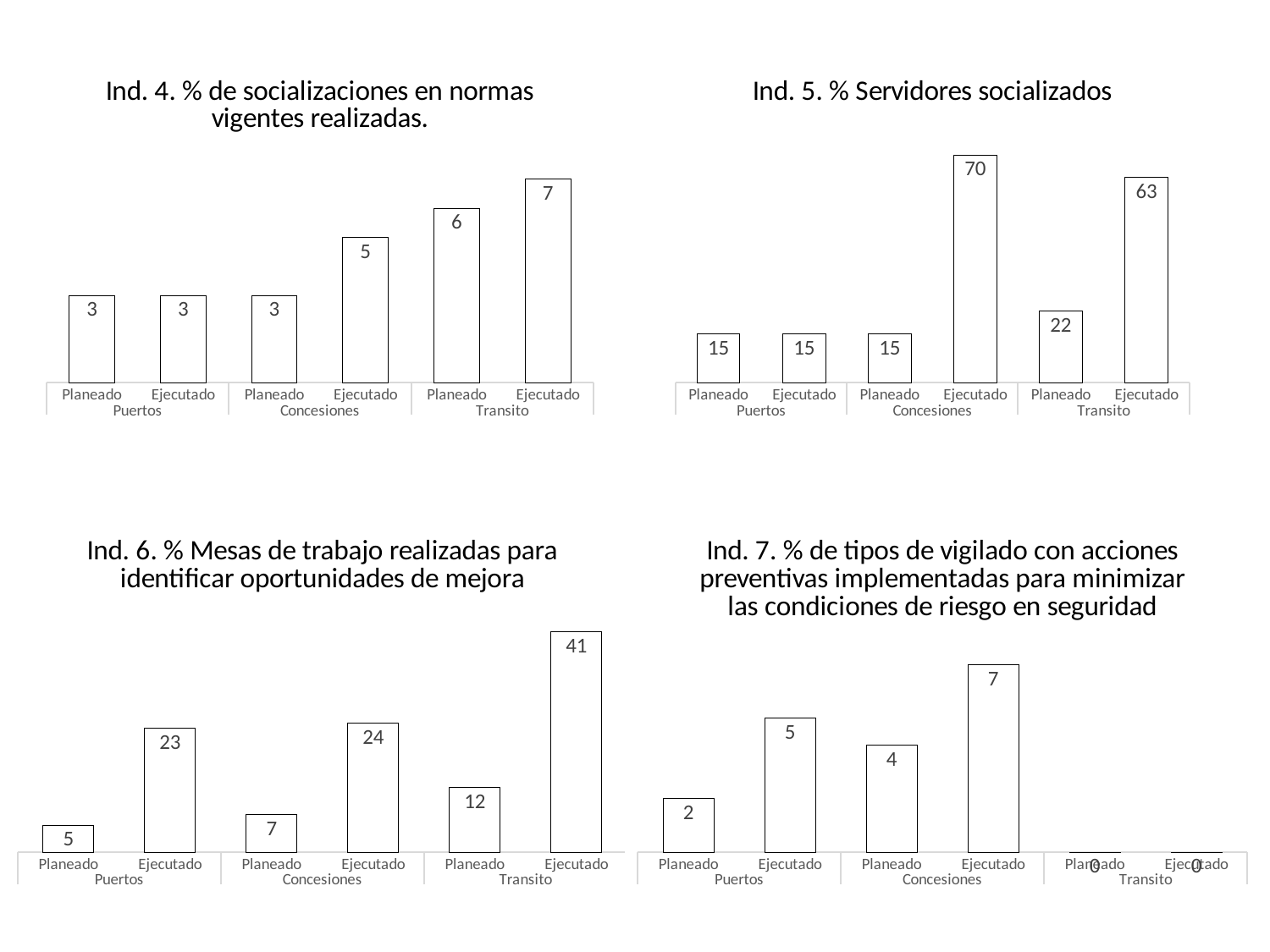
In the chart 'Ind. 7. % de tipos de vigilado con acciones preventivas implementadas para minimizar las condiciones de riesgo en seguridad', what is the Ejecutado value for Concesiones? 7 How many bars are plotted in the chart 'Ind. 4. % de socializaciones en normas vigentes realizadas.'? 6 In the chart 'Ind. 6. % Mesas de trabajo realizadas para identificar oportunidades de mejora', what is the Planeado value for Transito? 12 In the chart 'Ind. 6. % Mesas de trabajo realizadas para identificar oportunidades de mejora', what is the difference between the Ejecutado and Planeado values for Puertos? 18 In the chart 'Ind. 5. % Servidores socializados', what is the Ejecutado value for Concesiones? 70 In the chart 'Ind. 6. % Mesas de trabajo realizadas para identificar oportunidades de mejora', which bar has the lowest value? Puertos Planeado In the chart 'Ind. 5. % Servidores socializados', which is larger: Concesiones Ejecutado or Transito Ejecutado? Concesiones Ejecutado In the chart 'Ind. 4. % de socializaciones en normas vigentes realizadas.', which bar has the highest value? Transito Ejecutado What type of chart is 'Ind. 5. % Servidores socializados'? Bar chart In the chart 'Ind. 4. % de socializaciones en normas vigentes realizadas.', what is the Ejecutado value for Concesiones? 5 In the chart 'Ind. 7. % de tipos de vigilado con acciones preventivas implementadas para minimizar las condiciones de riesgo en seguridad', what is the Planeado value for Transito? 0 In the chart 'Ind. 5. % Servidores socializados', what is the difference between the Ejecutado and Planeado values for Transito? 41